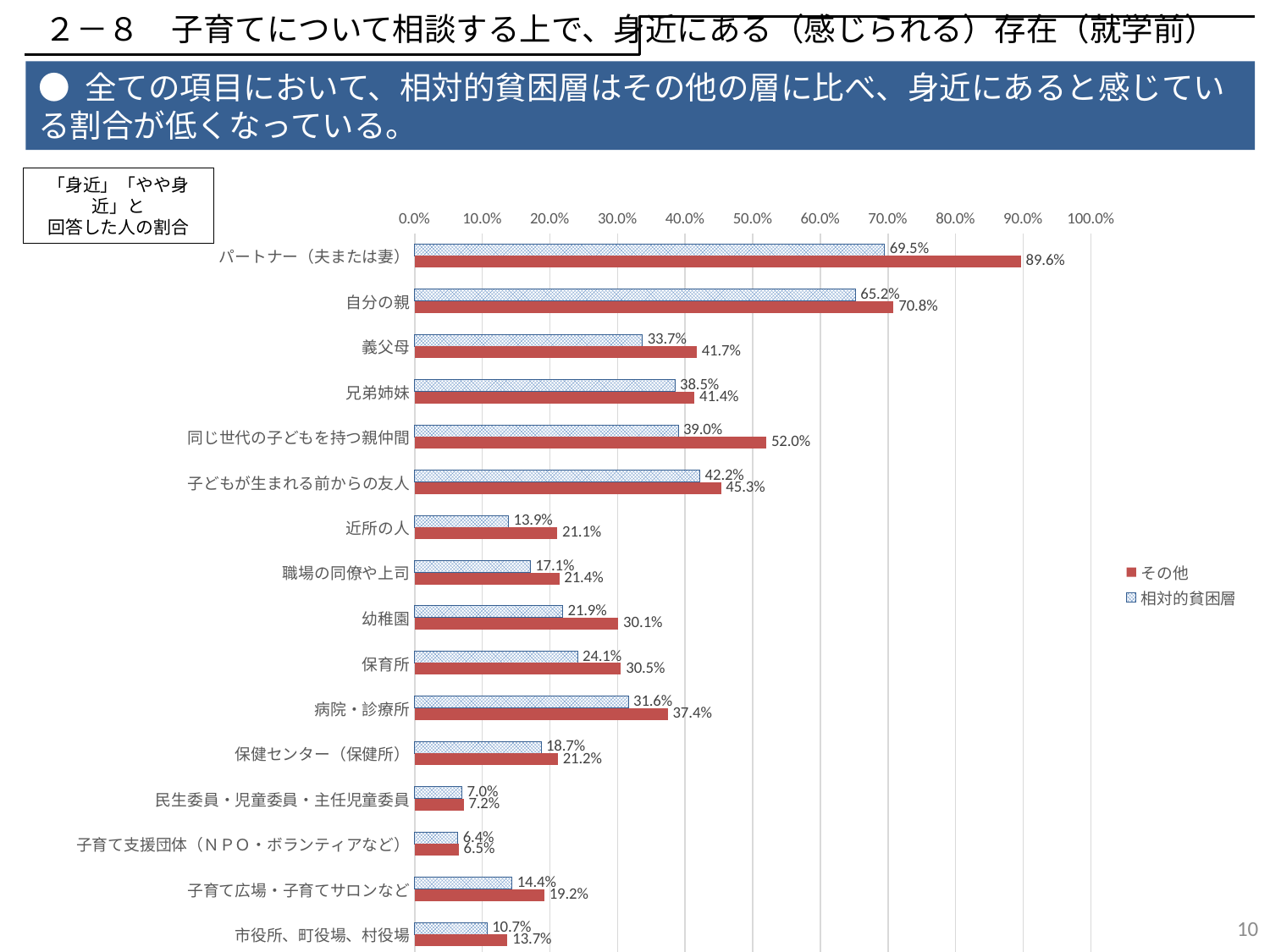
What is the difference between その他 and 相対的貧困層 for パートナー（夫または妻）? 20.1% What is the value for その他 for パートナー（夫または妻）? 89.6% How many series does the legend list? 2 What kind of chart is shown on the slide? Bar chart Which series is shown in red in the legend? その他 For 近所の人, which series has the larger value, その他 or 相対的貧困層? その他 Which category has the lowest value for 相対的貧困層? 子育て支援団体（ＮＰＯ・ボランティアなど） What is the value for 相対的貧困層 for 同じ世代の子どもを持つ親仲間? 39.0% Which category has the highest value for その他? パートナー（夫または妻） What is the difference between その他 and 相対的貧困層 for 幼稚園? 8.2% What is the value for 相対的貧困層 for 病院・診療所? 31.6% How many categories are shown on the chart? 16